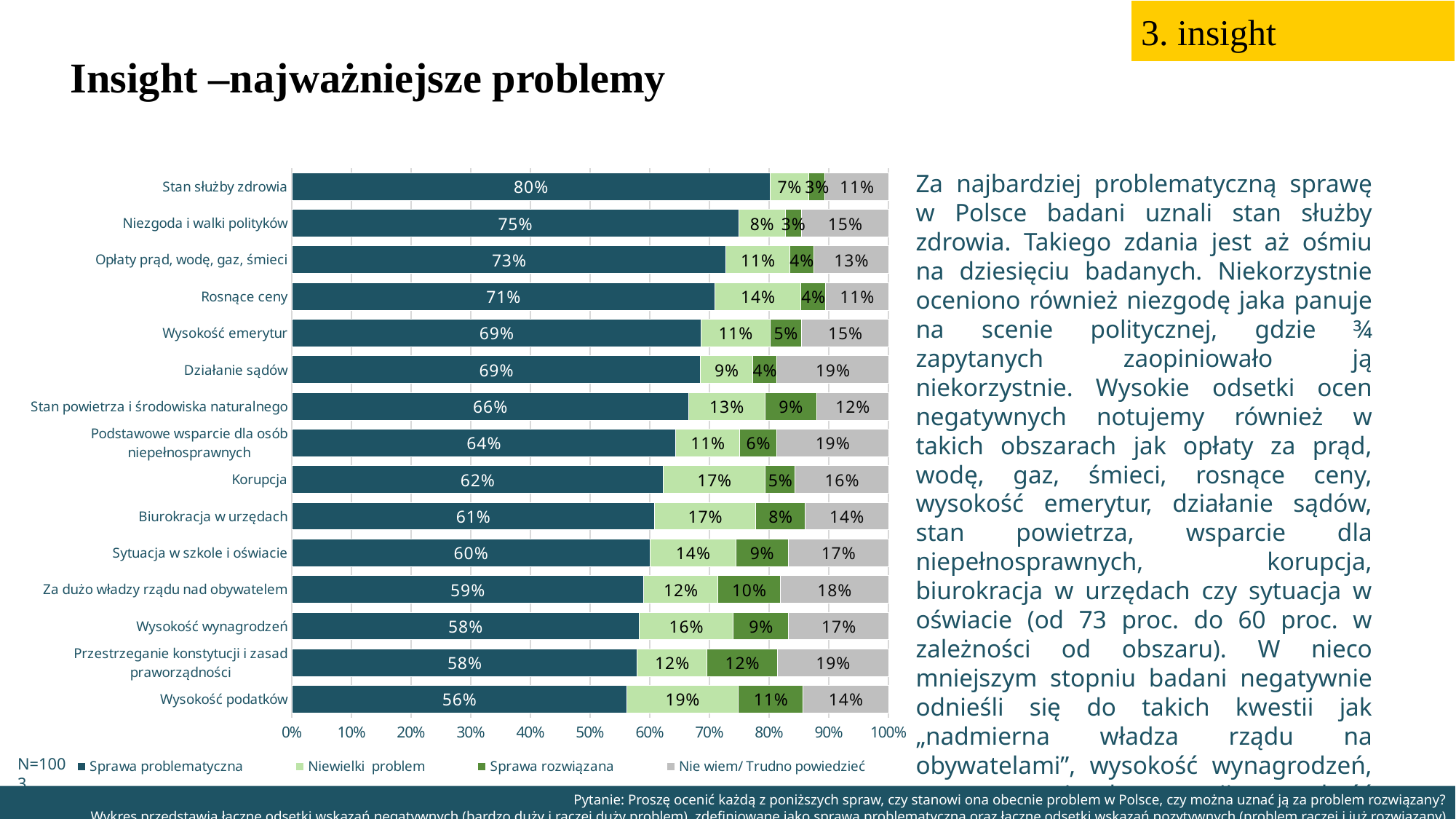
How many categories (problems) are shown in the chart? 15 How many series does the legend list? 4 What is the difference in 'Sprawa problematyczna' share between 'Stan służby zdrowia' and 'Niezgoda i walki polityków'? 5% What is the 'Sprawa rozwiązana' value for 'Przestrzeganie konstytucji i zasad praworządności'? 12% What type of chart is shown on the slide? Stacked bar chart Which legend entry is shown in grey? Nie wiem/ Trudno powiedzieć Which has a larger 'Sprawa rozwiązana' share: 'Korupcja' or 'Biurokracja w urzędach'? Biurokracja w urzędach Which category has the lowest 'Sprawa problematyczna' share? Wysokość podatków Which category has the highest 'Sprawa problematyczna' share? Stan służby zdrowia What percentage of respondents rated 'Stan służby zdrowia' as 'Sprawa problematyczna'? 80% What is the 'Niewielki problem' value for 'Wysokość podatków'? 19% What is the 'Nie wiem/ Trudno powiedzieć' value for 'Działanie sądów'? 19%